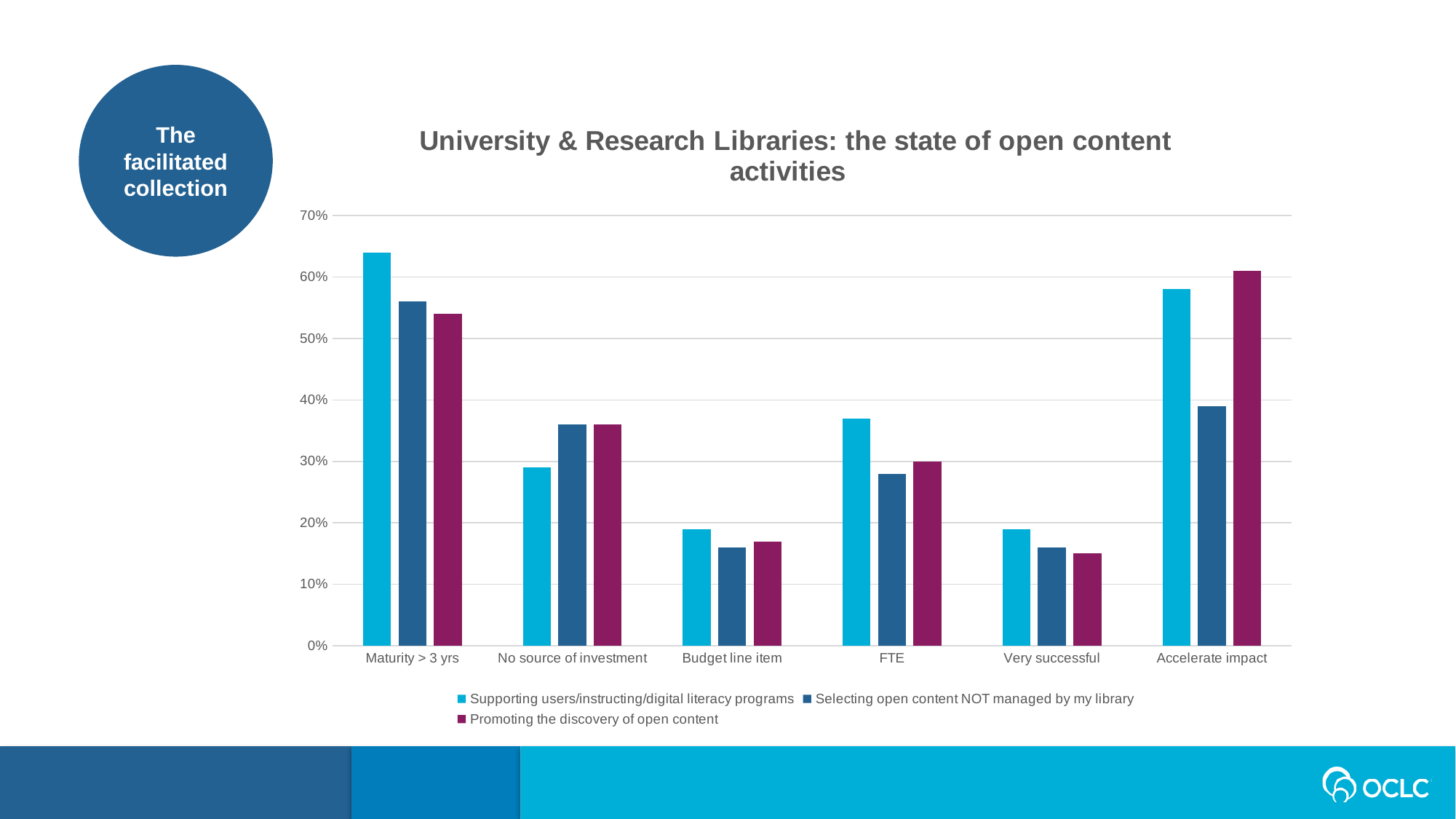
How many series does the chart's legend list? 3 What is the title of the chart? University & Research Libraries: the state of open content activities For which category is the 'Promoting the discovery of open content' bar the highest? Accelerate impact For which category is the 'Supporting users/instructing/digital literacy programs' bar the highest? Maturity > 3 yrs What type of chart is shown on the slide? Bar chart Is the value for 'Supporting users/instructing/digital literacy programs' at 'Maturity > 3 yrs' greater or less than 60%? greater Which series is shown in the dark purple colour in the chart? Promoting the discovery of open content At 'FTE', which is larger: 'Supporting users/instructing/digital literacy programs' or 'Selecting open content NOT managed by my library'? Supporting users/instructing/digital literacy programs How many categories are shown on the x axis of the chart? 6 Is the value for 'Promoting the discovery of open content' at 'Very successful' greater or less than 20%? less Is the value for 'Supporting users/instructing/digital literacy programs' at 'FTE' greater or less than 30%? greater At 'Accelerate impact', which is larger: 'Promoting the discovery of open content' or 'Selecting open content NOT managed by my library'? Promoting the discovery of open content